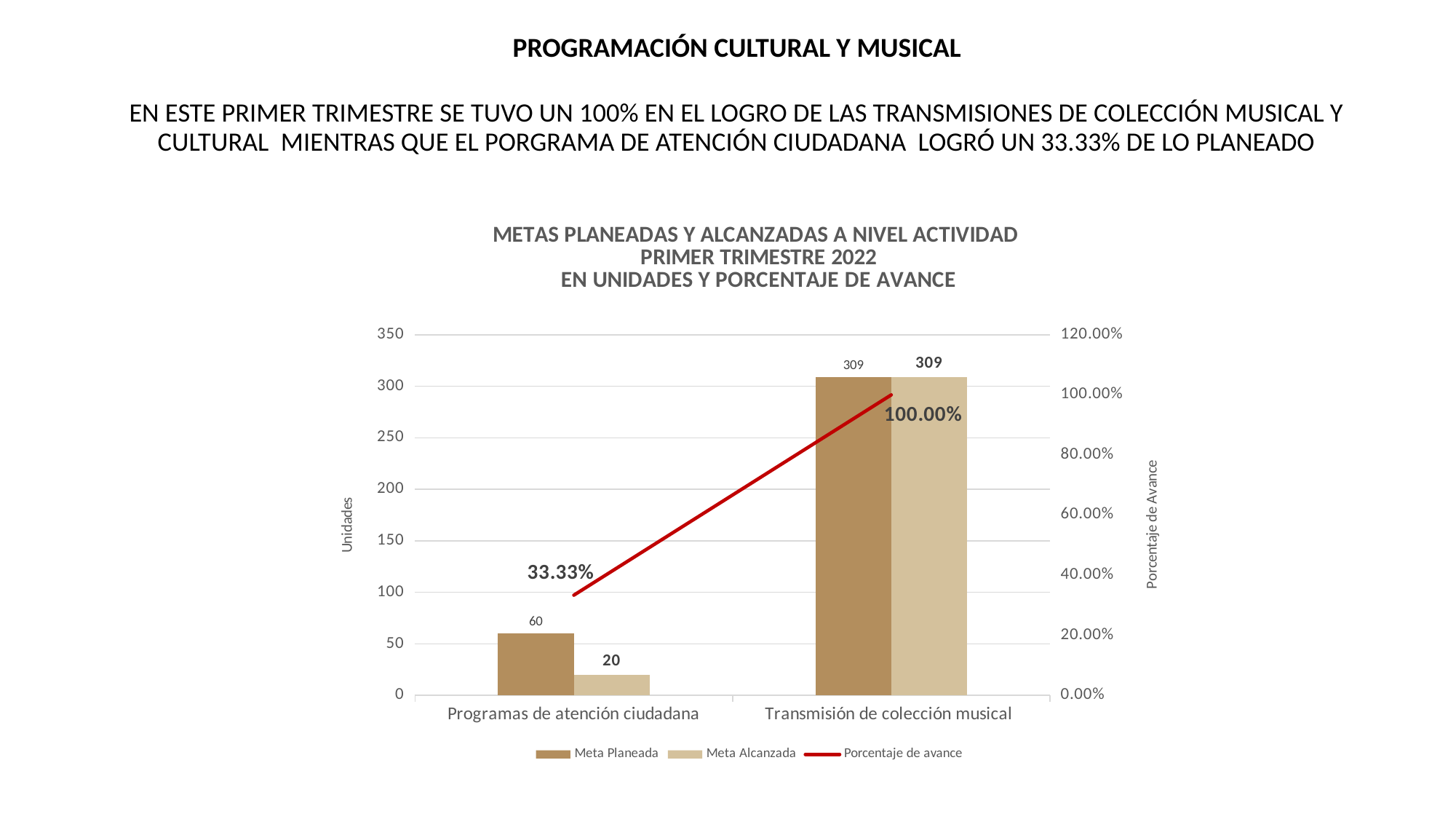
What is the Porcentaje de avance for Transmisión de colección musical? 100.00% Which category has the lowest Meta Alcanzada value? Programas de atención ciudadana What is the Meta Planeada value for Programas de atención ciudadana? 60 How many categories are shown on the x axis? 2 Does the Porcentaje de avance line rise or fall from Programas de atención ciudadana to Transmisión de colección musical? rise How many series does the legend list? 3 What is the Meta Planeada value for Transmisión de colección musical? 309 What is the difference between Meta Planeada and Meta Alcanzada for Programas de atención ciudadana? 40 Which is larger: the Meta Alcanzada for Transmisión de colección musical or the Meta Alcanzada for Programas de atención ciudadana? Transmisión de colección musical What is the Meta Alcanzada value for Programas de atención ciudadana? 20 What is the Porcentaje de avance for Programas de atención ciudadana? 33.33% Which category has the highest Meta Planeada value? Transmisión de colección musical